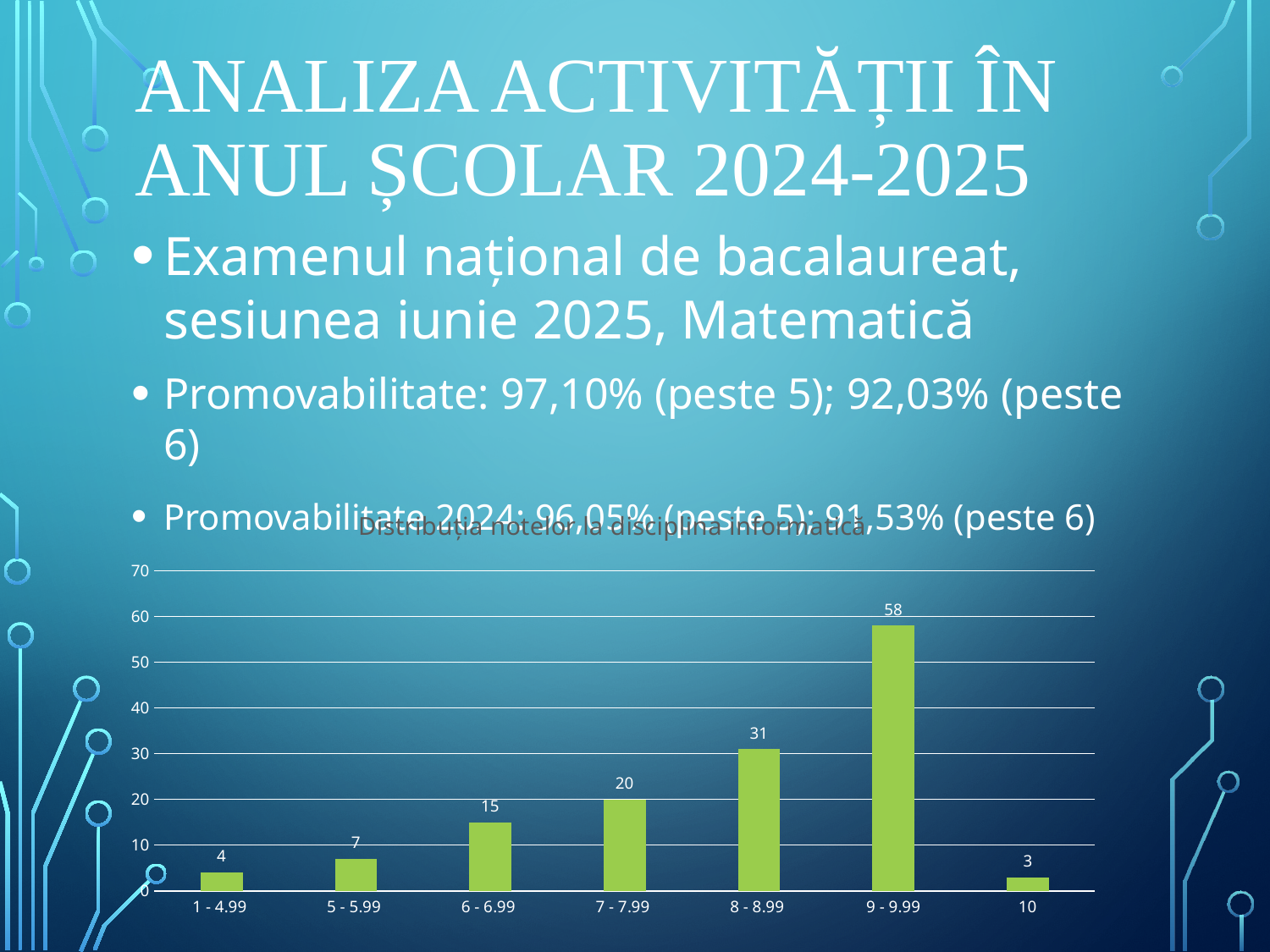
What is the difference between the values for 6 - 6.99 and 5 - 5.99? 8 Is the value for 8 - 8.99 greater or less than 40? less What kind of chart is shown on the slide? bar chart What is the value for the 7 - 7.99 category? 20 What is the value for the 1 - 4.99 category? 4 What is the value for the 10 category? 3 What is the value for the 9 - 9.99 category? 58 Which is larger, the value for 8 - 8.99 or the value for 7 - 7.99? 8 - 8.99 Which category has the lowest value? 10 Which category has the highest value? 9 - 9.99 How many categories are shown on the x axis? 7 What is the difference between the values for 9 - 9.99 and 8 - 8.99? 27